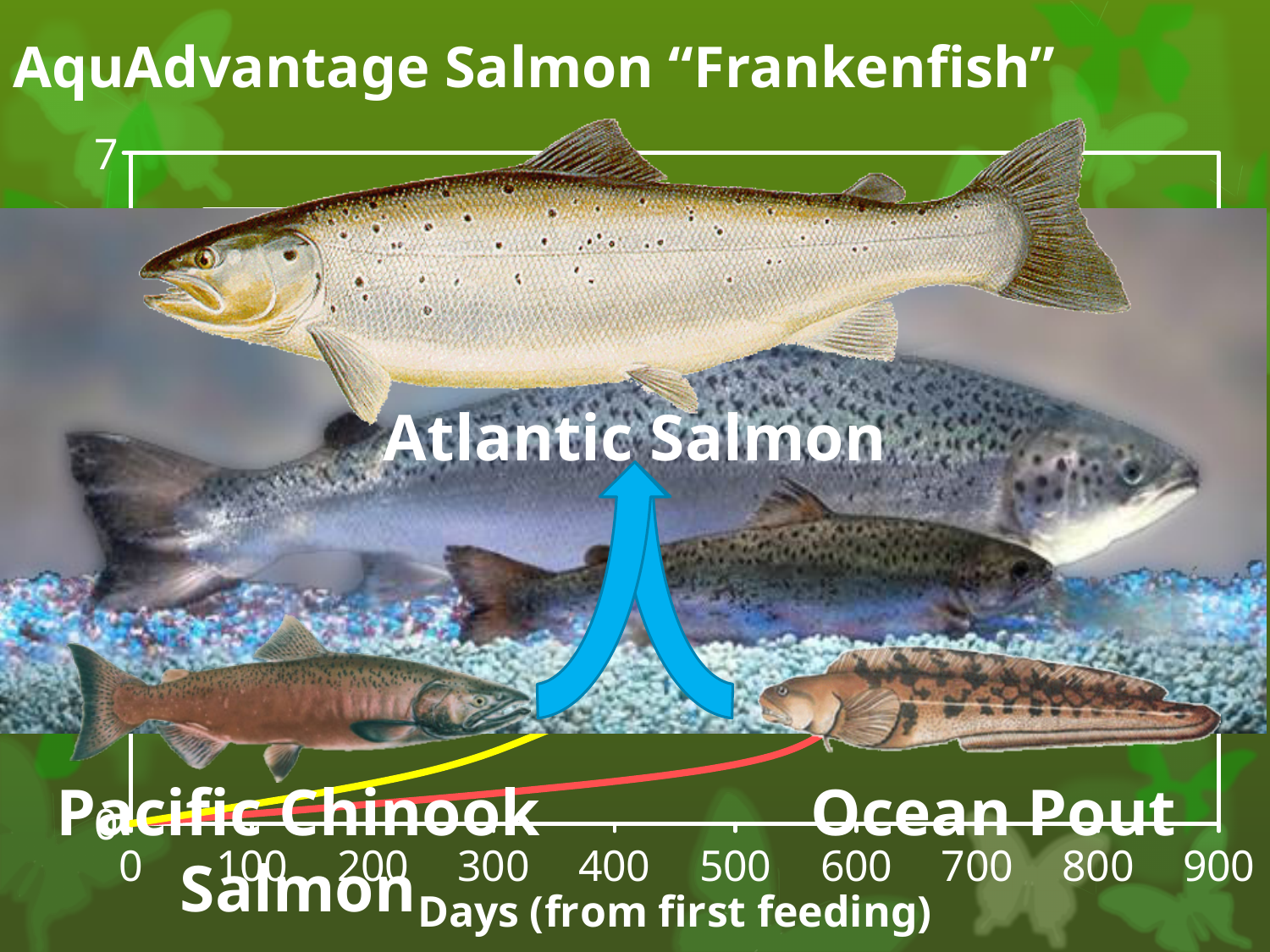
How many tick labels are shown on the x axis? 10 What is the title of the x axis? Days (from first feeding) Does the red line rise or fall as the number of days increases? rise At 300 days, which line is higher, the yellow line or the red line? the yellow line How many lines are plotted on the chart? 2 Which line rises more steeply, the yellow line or the red line? the yellow line What is the largest value labelled on the x axis? 900 Does the yellow line rise or fall as the number of days increases? rise What kind of chart is shown on the slide? line chart